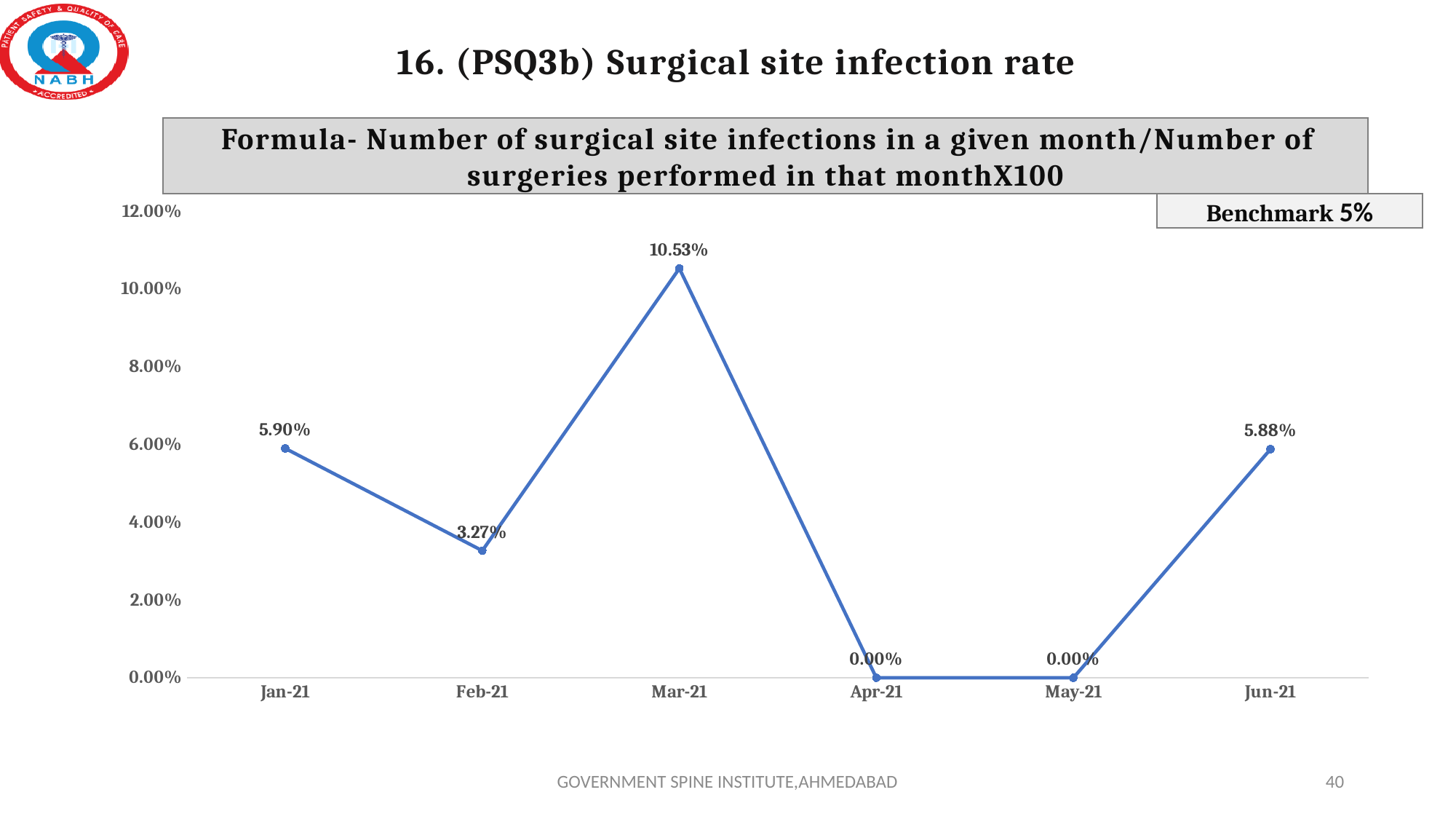
What is the surgical site infection rate for Jun-21? 5.88% Is the value for Mar-21 greater or less than 10.00%? greater What benchmark value is stated on the slide? 5% What is the surgical site infection rate for Jan-21? 5.90% What kind of chart is shown on the slide? Line chart What is the surgical site infection rate for Mar-21? 10.53% What is the surgical site infection rate for Feb-21? 3.27% Which month has the highest surgical site infection rate? Mar-21 Which month has a higher surgical site infection rate, Jan-21 or Feb-21? Jan-21 What is the difference between the surgical site infection rates for Mar-21 and Feb-21? 7.26% How many months are plotted on the chart? 6 Which months have a surgical site infection rate of 0.00%? Apr-21 and May-21